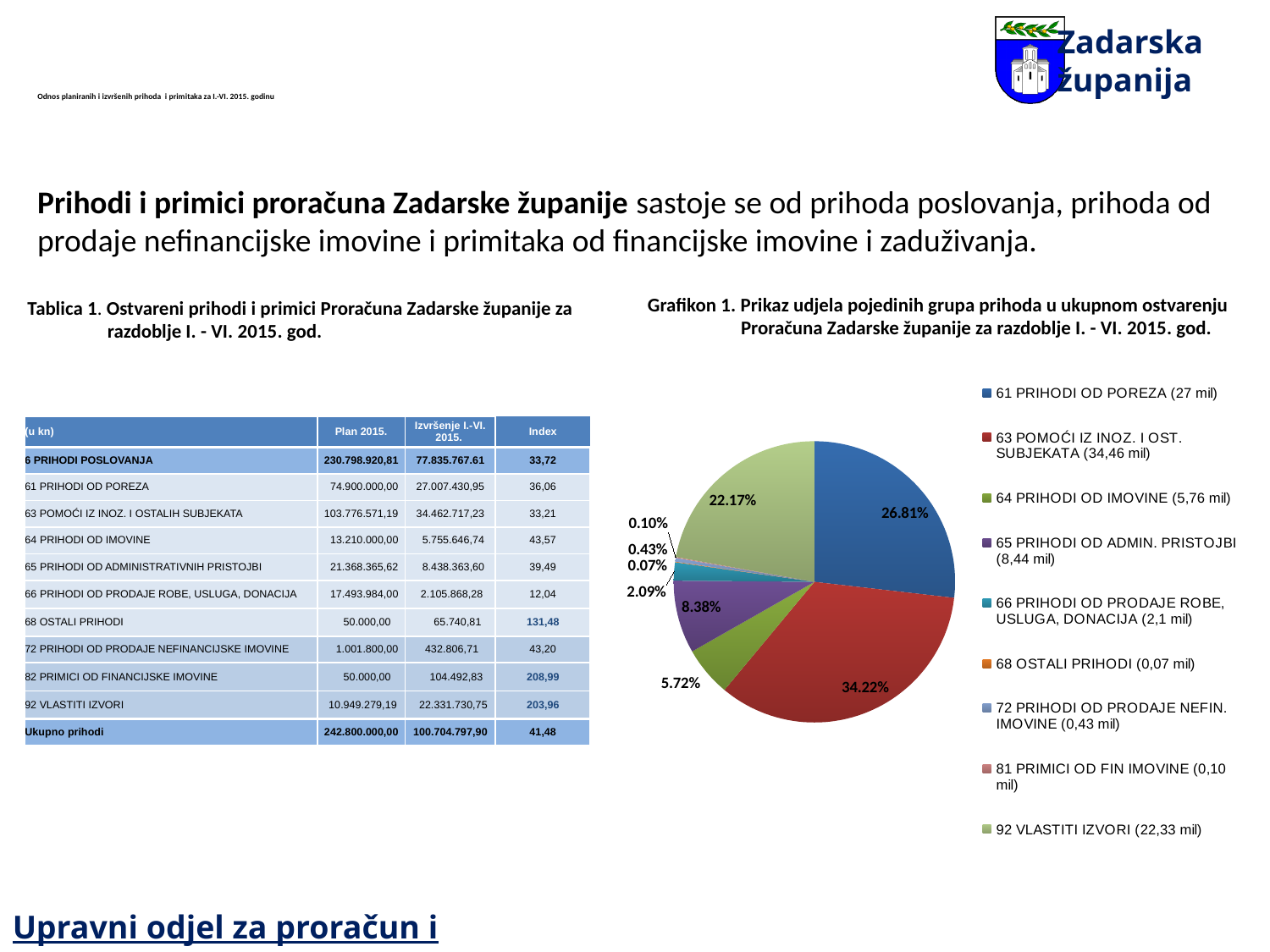
Which category has the largest slice in the pie chart? 63 POMOĆI IZ INOZ. I OST. SUBJEKATA In the pie chart, what share is shown for 65 PRIHODI OD ADMIN. PRISTOJBI? 8.38% In the pie chart, what share is shown for 63 POMOĆI IZ INOZ. I OST. SUBJEKATA? 34.22% Which category has the smallest slice in the pie chart? 68 OSTALI PRIHODI In the pie chart, what is the difference between the share for 63 POMOĆI IZ INOZ. I OST. SUBJEKATA and the share for 61 PRIHODI OD POREZA? 7.41% In the pie chart, which is larger: the share for 61 PRIHODI OD POREZA or the share for 92 VLASTITI IZVORI? 61 PRIHODI OD POREZA In the pie chart, what share is shown for 64 PRIHODI OD IMOVINE? 5.72% How many categories does the legend of the pie chart list? 9 What is the title of the pie chart on the slide? Grafikon 1. Prikaz udjela pojedinih grupa prihoda u ukupnom ostvarenju Proračuna Zadarske županije za razdoblje I. - VI. 2015. god. In the pie chart, what share is shown for 92 VLASTITI IZVORI? 22.17% In the pie chart, what share is shown for 61 PRIHODI OD POREZA? 26.81% What type of chart is Grafikon 1 on the slide? pie chart